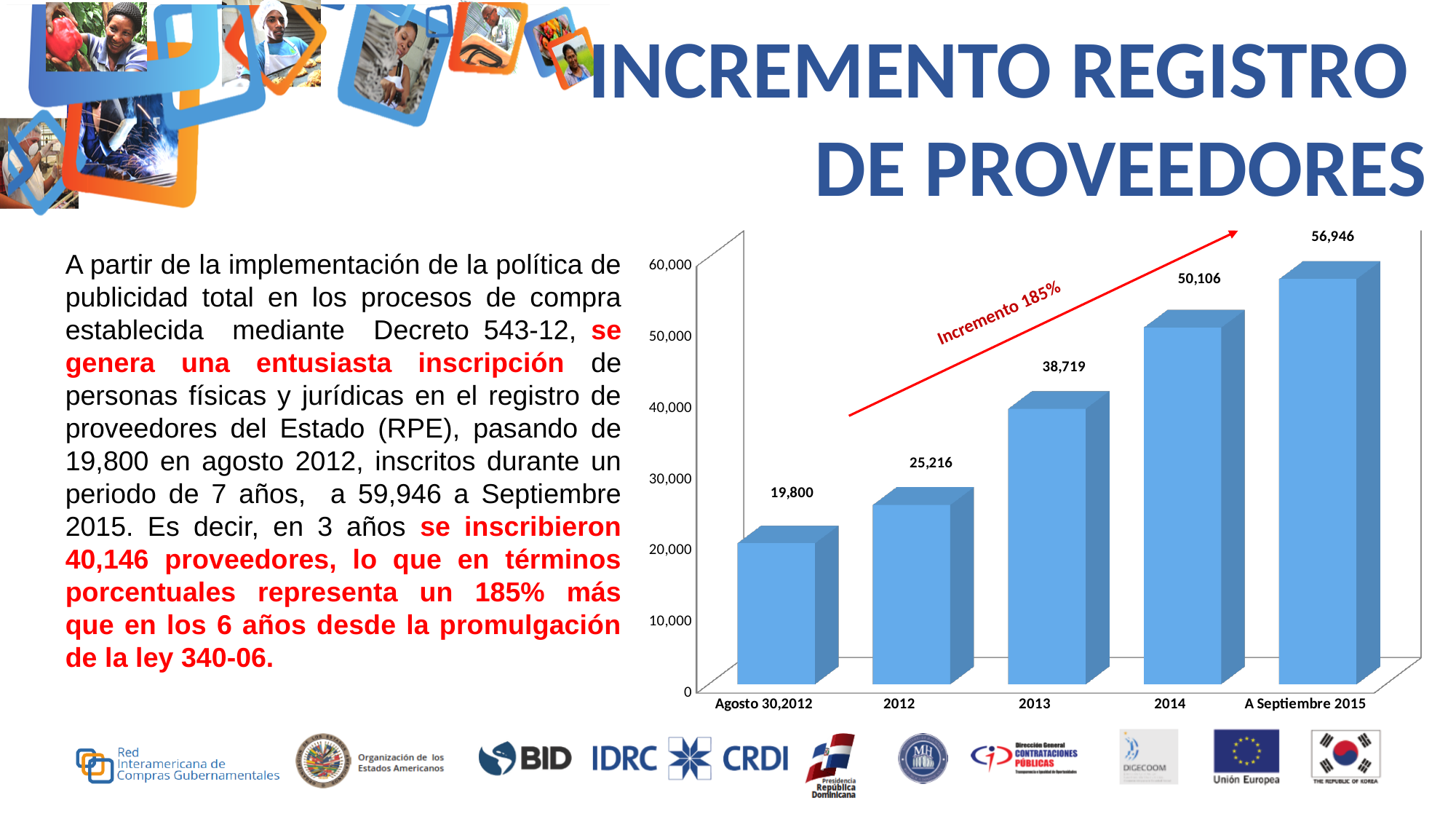
How many bars are shown in the chart? 5 Which category has the lowest value? Agosto 30,2012 What is the difference between the values for A Septiembre 2015 and Agosto 30,2012? 37,146 Is the value for 2012 greater or less than 30,000? less Do the values rise or fall from left to right along the x axis? rise What is the value for Agosto 30,2012? 19,800 What kind of chart is shown on the slide? bar chart What is the difference between the values for 2014 and 2013? 11,387 What is the value for 2013? 38,719 Which category has the highest value? A Septiembre 2015 What is the value for A Septiembre 2015? 56,946 Which is larger, the value for 2012 or the value for 2014? 2014